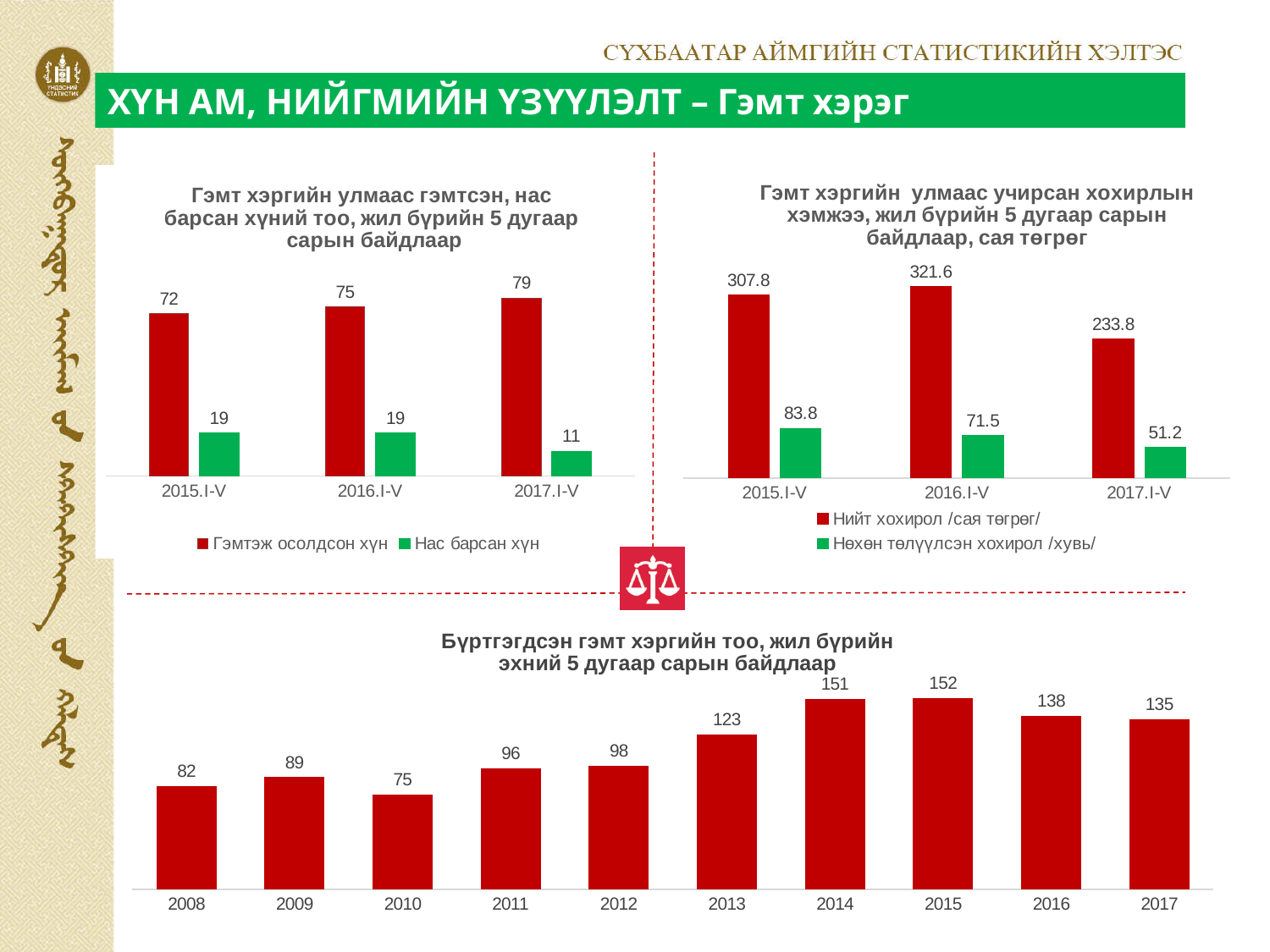
In the top-right chart (Гэмт хэргийн улмаас учирсан хохирлын хэмжээ), what is the difference between Нийт хохирол in 2016.I-V and 2017.I-V? 87.8 In the top-left chart (Гэмт хэргийн улмаас гэмтсэн, нас барсан хүний тоо), does the value for Гэмтэж осолдсон хүн rise or fall from 2015.I-V to 2017.I-V? rise In the top-left chart (Гэмт хэргийн улмаас гэмтсэн, нас барсан хүний тоо), what is the value for Нас барсан хүн in 2017.I-V? 11 In the bottom chart (Бүртгэгдсэн гэмт хэргийн тоо), what is the difference between the values for 2014 and 2008? 69 In the bottom chart (Бүртгэгдсэн гэмт хэргийн тоо), what is the value for 2013? 123 In the bottom chart (Бүртгэгдсэн гэмт хэргийн тоо), how many years are shown on the x axis? 10 In the top-left chart (Гэмт хэргийн улмаас гэмтсэн, нас барсан хүний тоо), how many series does the legend list? 2 In the bottom chart (Бүртгэгдсэн гэмт хэргийн тоо), which year has the lowest value? 2010 In the bottom chart (Бүртгэгдсэн гэмт хэргийн тоо), is the value for 2016 larger or smaller than the value for 2017? larger What type of chart is the top-right chart (Гэмт хэргийн улмаас учирсан хохирлын хэмжээ)? bar chart In the top-right chart (Гэмт хэргийн улмаас учирсан хохирлын хэмжээ), what is the value for Нийт хохирол in 2016.I-V? 321.6 In the bottom chart (Бүртгэгдсэн гэмт хэргийн тоо), which year has the highest value? 2015